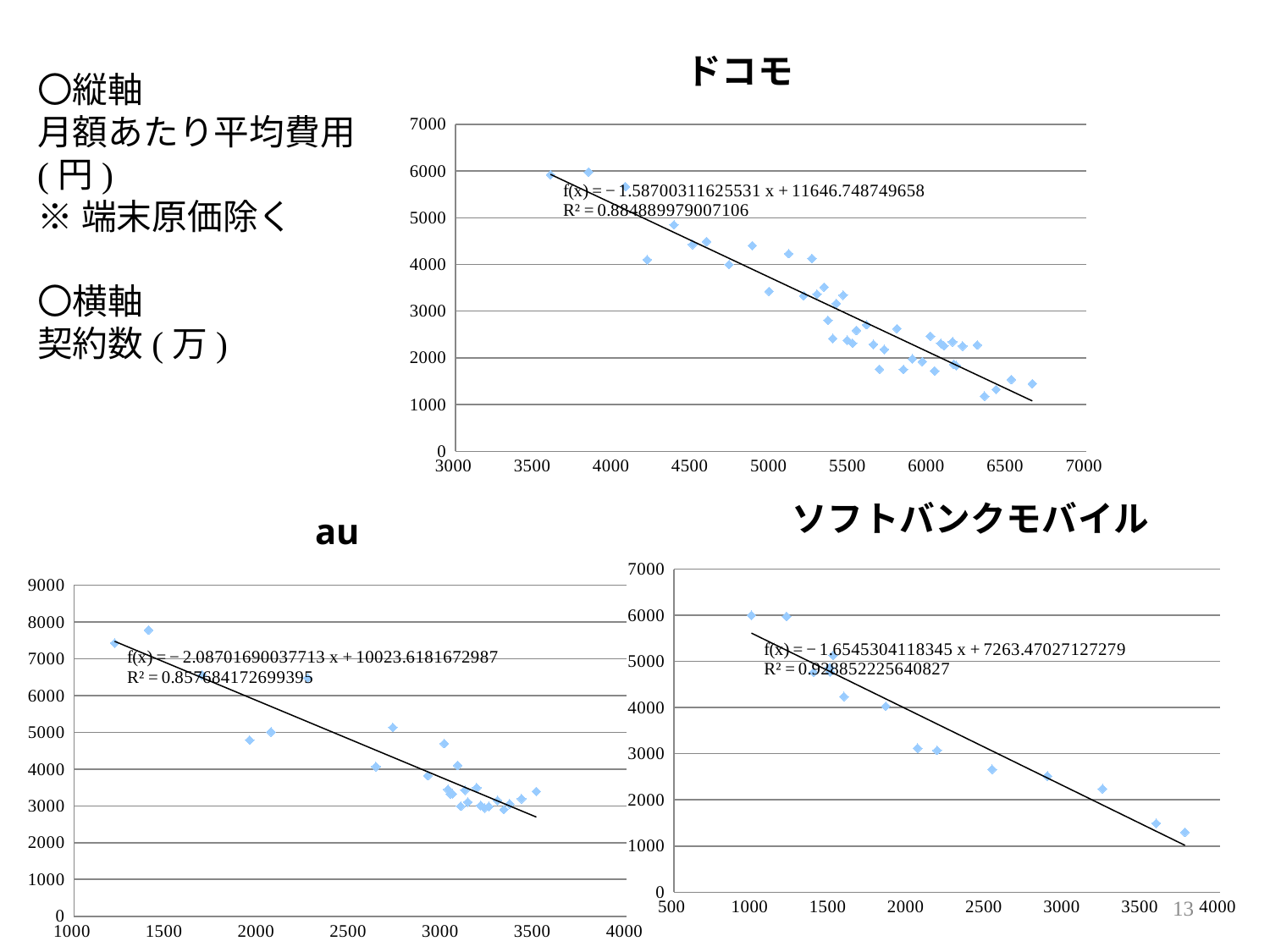
In the ドコモ chart, do the plotted values rise or fall as the contract count on the x axis increases? fall Which of the three charts shows the highest R² value? ソフトバンクモバイル In the au chart, do the plotted values rise or fall as the x-axis value increases? fall What is the R² value shown on the au chart? 0.857684172699395 What is the R² value shown on the ソフトバンクモバイル chart? 0.928852225640827 How many charts are shown on the slide? 3 What kind of chart is the ドコモ chart? scatter chart What is the slope of the trendline equation shown on the au chart? −2.08701690037713 What is the R² value shown on the ドコモ chart? 0.884889979007106 Which of the three charts shows the lowest R² value? au What is the intercept of the trendline equation shown on the ソフトバンクモバイル chart? 7263.47027127279 In the ソフトバンクモバイル chart, is the value of the leftmost point (smallest contract count) greater or less than 5000? greater